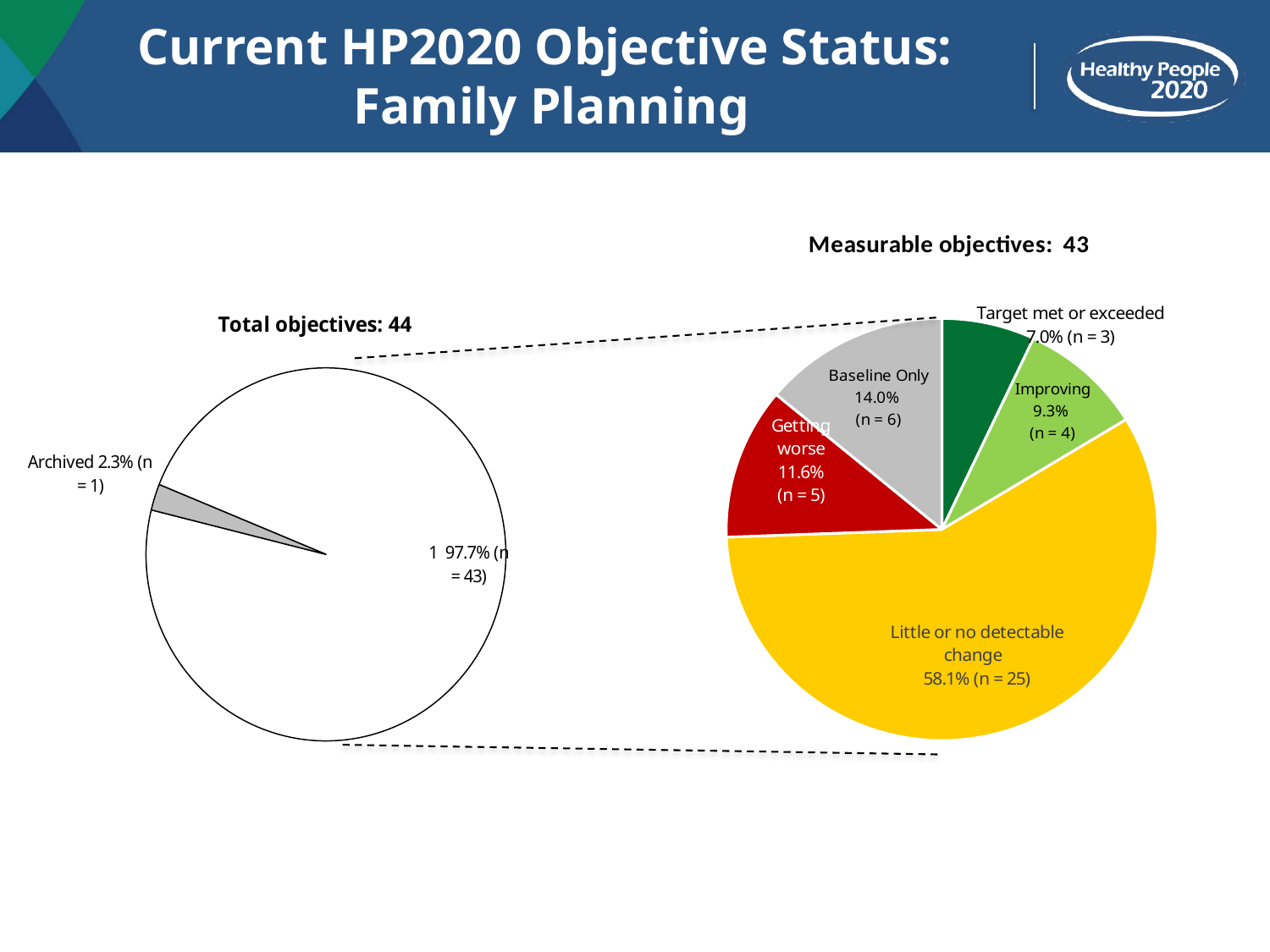
In the 'Total objectives: 44' pie chart, what percentage is labelled for 'Archived'? 2.3% In the 'Measurable objectives: 43' pie chart, which category has the smallest slice? Target met or exceeded In the 'Measurable objectives: 43' pie chart, how many objectives (n) are in the 'Getting worse' slice? 5 In the 'Measurable objectives: 43' pie chart, what colour is the 'Getting worse' slice? Red In the 'Measurable objectives: 43' pie chart, which category has the largest slice? Little or no detectable change In the 'Measurable objectives: 43' pie chart, which slice is larger: 'Getting worse' or 'Improving'? Getting worse How many slices does the 'Measurable objectives: 43' pie chart have? 5 In the 'Measurable objectives: 43' pie chart, what percentage is labelled for 'Little or no detectable change'? 58.1% What kind of chart is used on the left side of the slide under 'Total objectives: 44'? Pie chart In the 'Measurable objectives: 43' pie chart, what percentage is labelled for 'Baseline Only'? 14.0% In the 'Measurable objectives: 43' pie chart, how many more objectives are 'Baseline Only' than 'Improving'? 2 In the 'Total objectives: 44' pie chart, how many objectives (n) are in the 'Archived' slice? 1